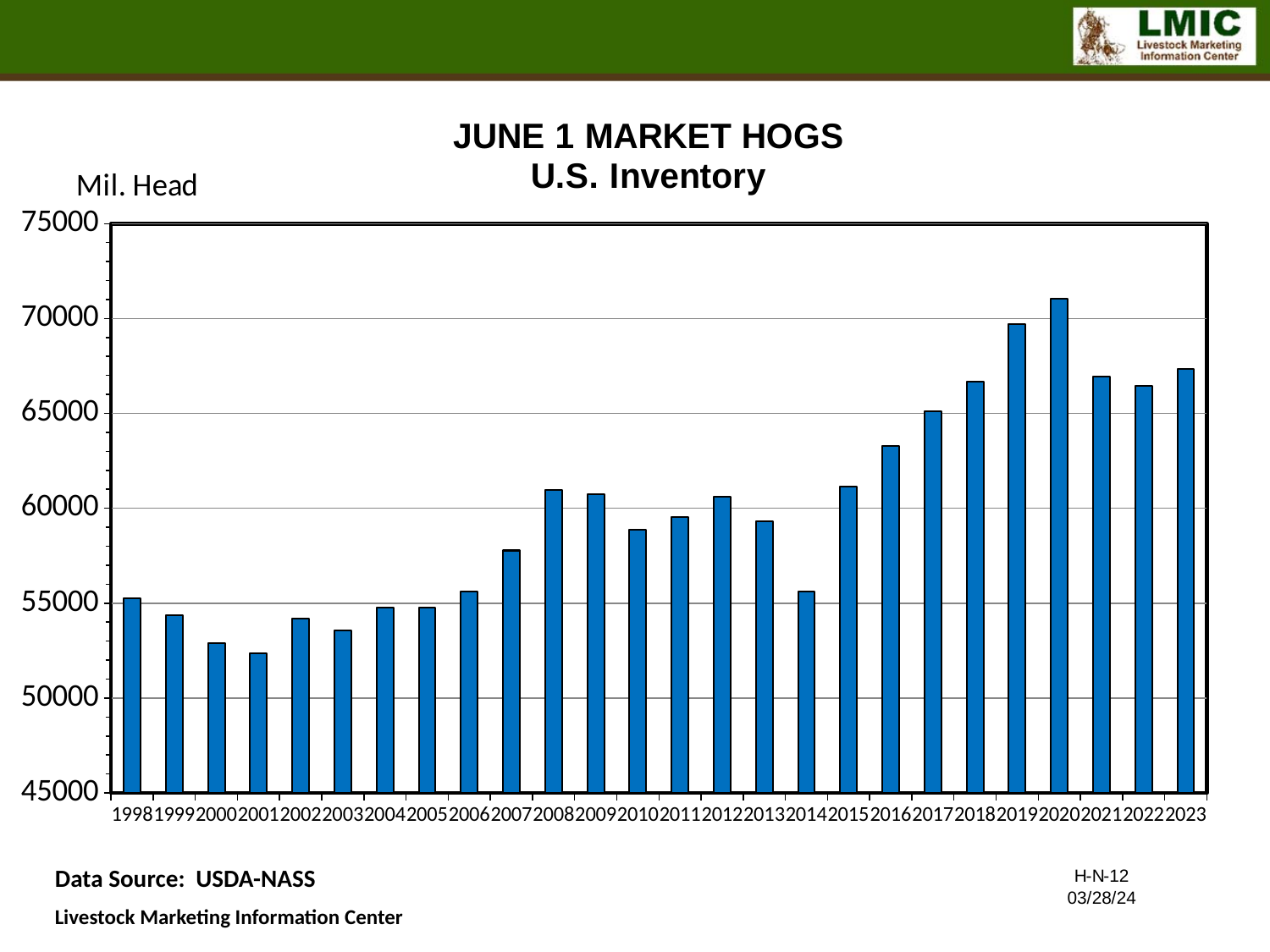
Which year has the highest June 1 market hog inventory? 2020 How many years are plotted on the x axis? 26 What kind of chart is shown on the slide? bar chart What unit is shown on the y axis of the chart? Mil. Head Is the value for 2001 greater or less than 55000? less Is the value for 2016 greater or less than 65000? less Which year has the lowest June 1 market hog inventory? 2001 Which year has the larger inventory, 2014 or 2015? 2015 Which year has the larger inventory, 2008 or 2013? 2008 Is the value for 2010 greater or less than 60000? less Do the values rise or fall from 2016 to 2020? rise